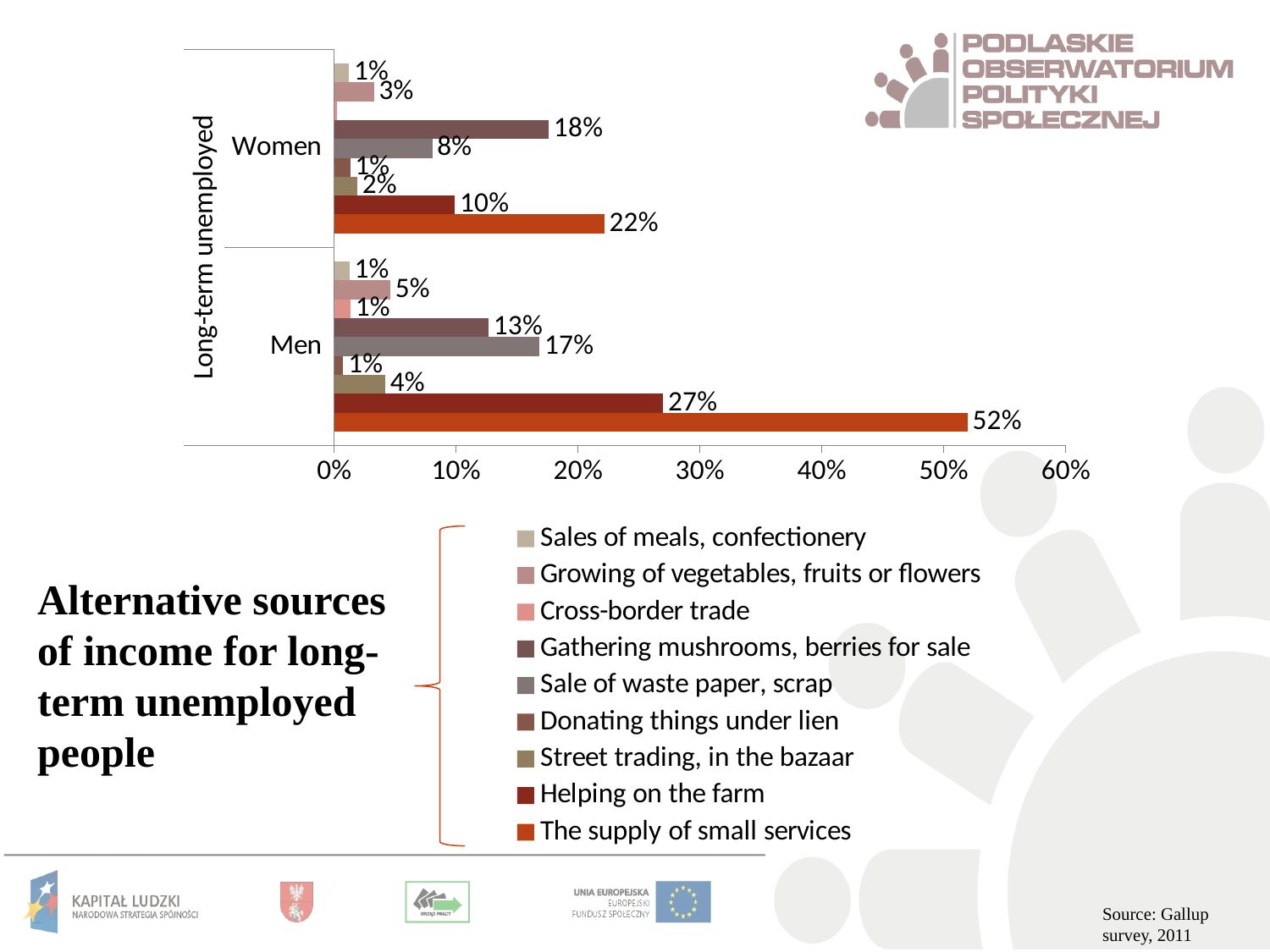
How many series does the legend list? 9 Which is larger for Women: 'Gathering mushrooms, berries for sale' or 'Helping on the farm'? Gathering mushrooms, berries for sale Which source of income has the highest value for Men? The supply of small services What is the value for 'Gathering mushrooms, berries for sale' among Women? 18% What type of chart is shown on the slide? bar chart What is the value for 'Helping on the farm' among Men? 27% What is the value for 'The supply of small services' among Men? 52% How many categories are shown on the vertical axis? 2 What is the difference between the Men and Women values for 'The supply of small services'? 30% What is the value for 'Sale of waste paper, scrap' among Men? 17% What is the maximum value shown on the horizontal axis? 60% What is the value for 'The supply of small services' among Women? 22%